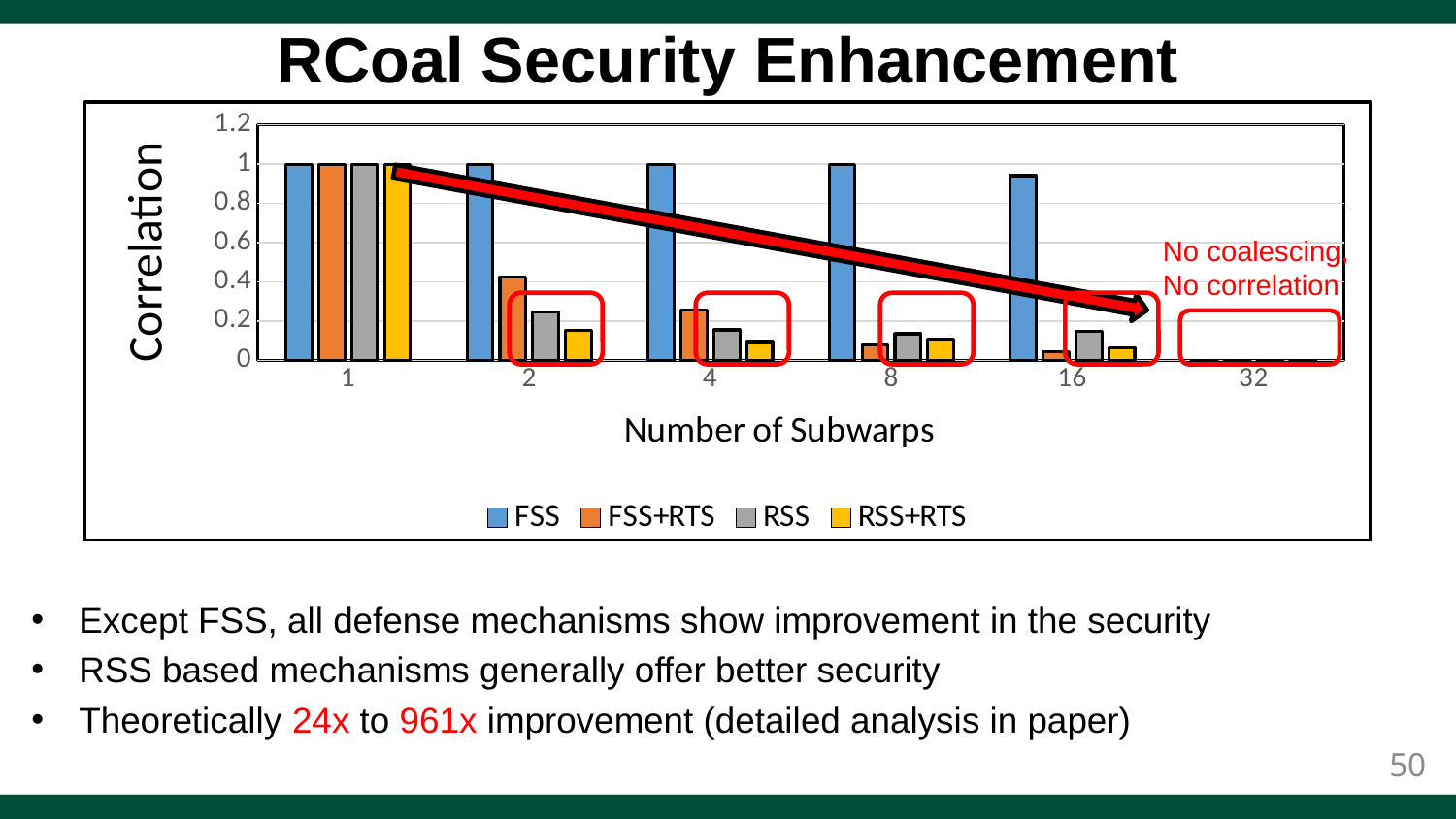
What is the title of the x axis of the chart? Number of Subwarps Does the Correlation for FSS+RTS rise or fall as the Number of Subwarps increases from 1 to 16? fall At 2 subwarps, which series has the lowest Correlation? RSS+RTS What kind of chart is shown on the slide? bar chart How many Number of Subwarps categories are shown on the x axis? 6 Is the Correlation value for RSS+RTS at 4 subwarps greater or less than 0.2? less At 2 subwarps, which series has the highest Correlation? FSS Is the Correlation value for FSS at 16 subwarps greater or less than 0.8? greater How many series does the legend list? 4 At 2 subwarps, which is larger: the Correlation for FSS+RTS or for RSS? FSS+RTS Is the Correlation value for FSS+RTS at 2 subwarps greater or less than 0.6? less